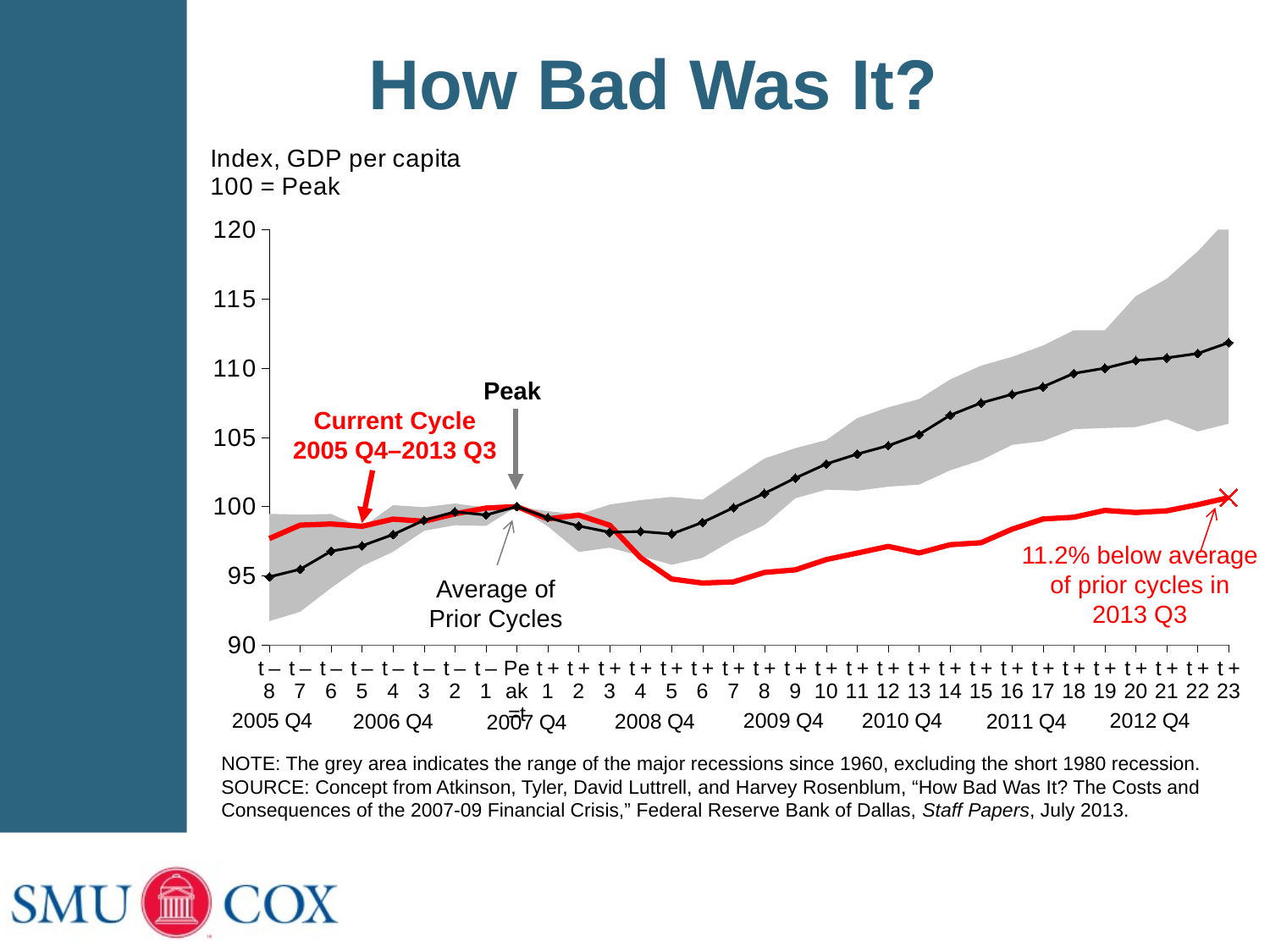
Does the Average of Prior Cycles line rise or fall from t+5 to t+23? rise Is the Average of Prior Cycles value at t+23 greater or less than 110? greater What kind of chart is shown on the slide? line chart How many points are on the x axis, from t-8 through Peak to t+23? 32 Is the Average of Prior Cycles value at t-8 greater or less than 100? less What is the index value of both series at the point labelled Peak? 100 By how much was the Current Cycle below the average of prior cycles in 2013 Q3, according to the annotation? 11.2% What period does the Current Cycle cover, according to the chart label? 2005 Q4–2013 Q3 According to the note, what does the grey area indicate? The range of the major recessions since 1960, excluding the short 1980 recession Is the Current Cycle value at t+23 greater or less than 105? less At t+23, which series is higher: the Current Cycle or the Average of Prior Cycles? Average of Prior Cycles